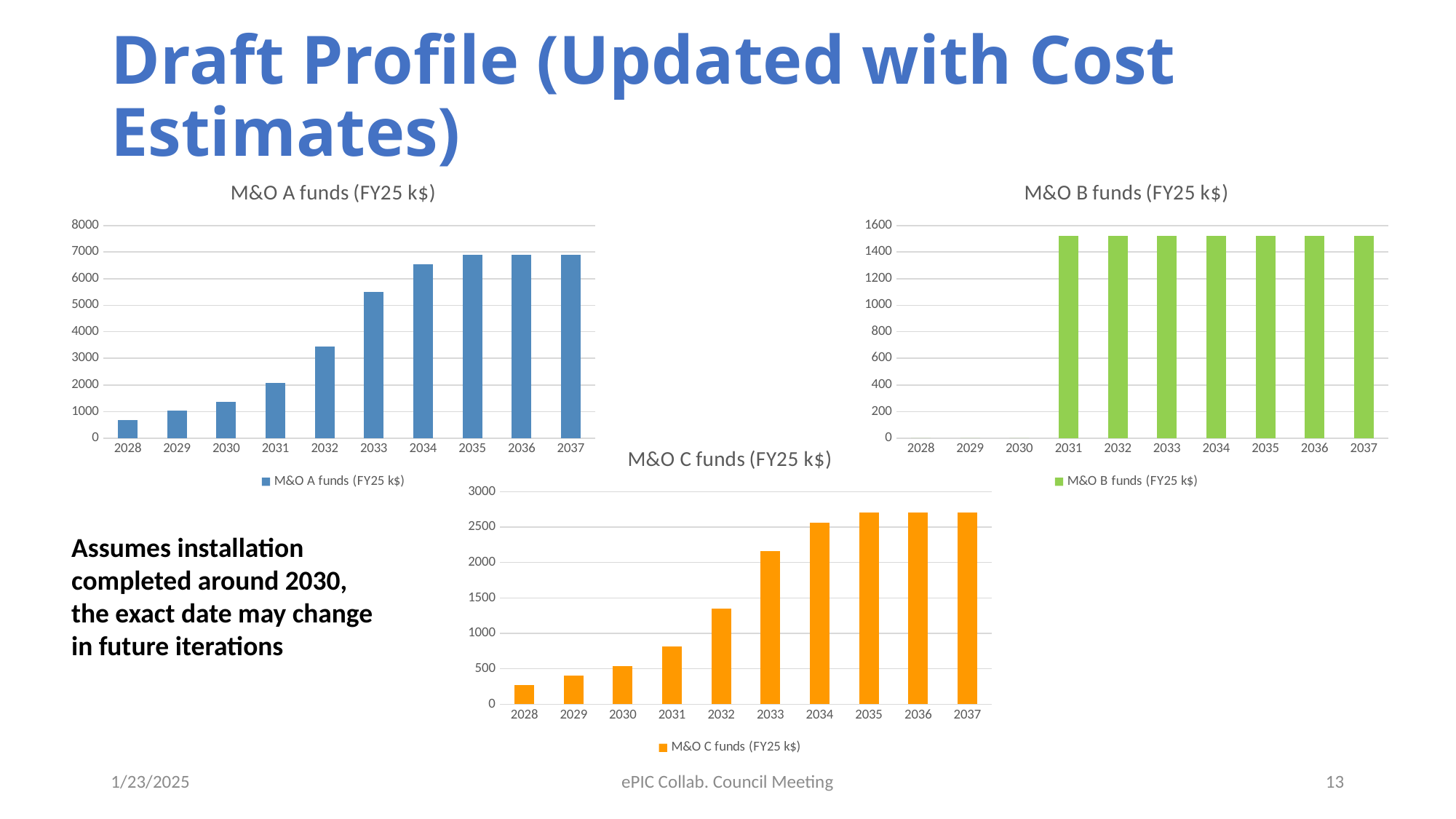
In the "M&O C funds (FY25 k$)" chart, do the values rise or fall from 2028 to 2035? rise What kind of chart is the "M&O A funds (FY25 k$)" chart? bar chart How many years are shown on the x axis of the "M&O B funds (FY25 k$)" chart? 10 In the "M&O B funds (FY25 k$)" chart, how many years have a visible bar? 7 In the "M&O A funds (FY25 k$)" chart, is the value for 2033 greater or less than 5000? greater In the "M&O C funds (FY25 k$)" chart, which year has the lowest value? 2028 What colour are the bars in the "M&O C funds (FY25 k$)" chart? orange In the "M&O C funds (FY25 k$)" chart, is the value for 2034 greater or less than 2500? greater In the "M&O B funds (FY25 k$)" chart, is the value for 2031 greater or less than 1400? greater In the "M&O A funds (FY25 k$)" chart, which year has the lowest value? 2028 In the "M&O A funds (FY25 k$)" chart, which is larger, the value for 2032 or the value for 2031? 2032